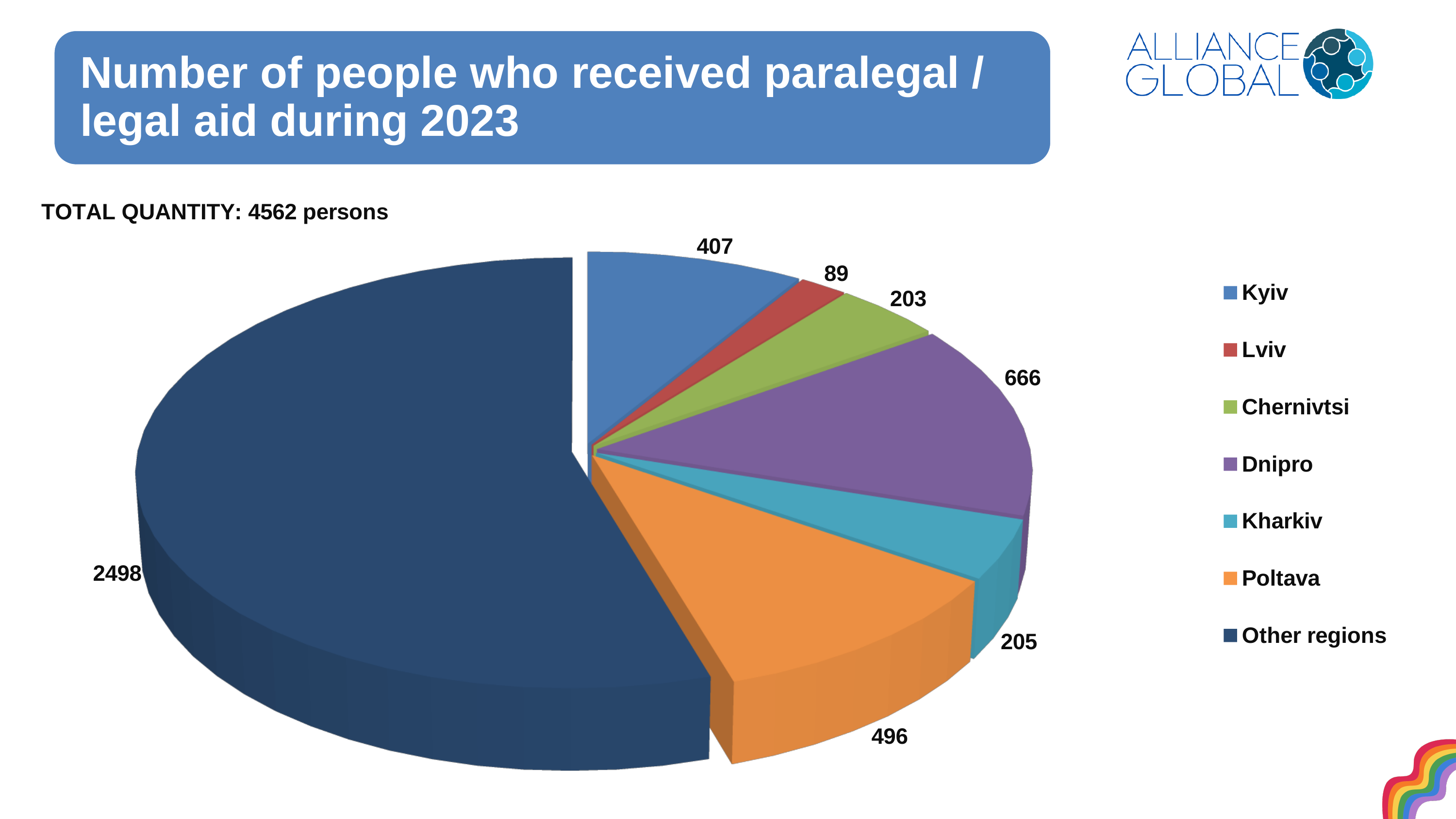
What total quantity of persons is stated on the slide? 4562 persons Which region has the smallest slice of the pie? Lviv What kind of chart is shown on the slide? pie chart How many categories does the pie chart have? 7 What is the value for Lviv? 89 Which category has the largest slice of the pie? Other regions What is the difference between the values for Dnipro and Poltava? 170 How many people received paralegal / legal aid in Kyiv? 407 What is the value for Poltava? 496 What is the value for Dnipro? 666 Which is larger, the value for Kharkiv or the value for Chernivtsi? Kharkiv What is the difference between the values for Kyiv and Chernivtsi? 204